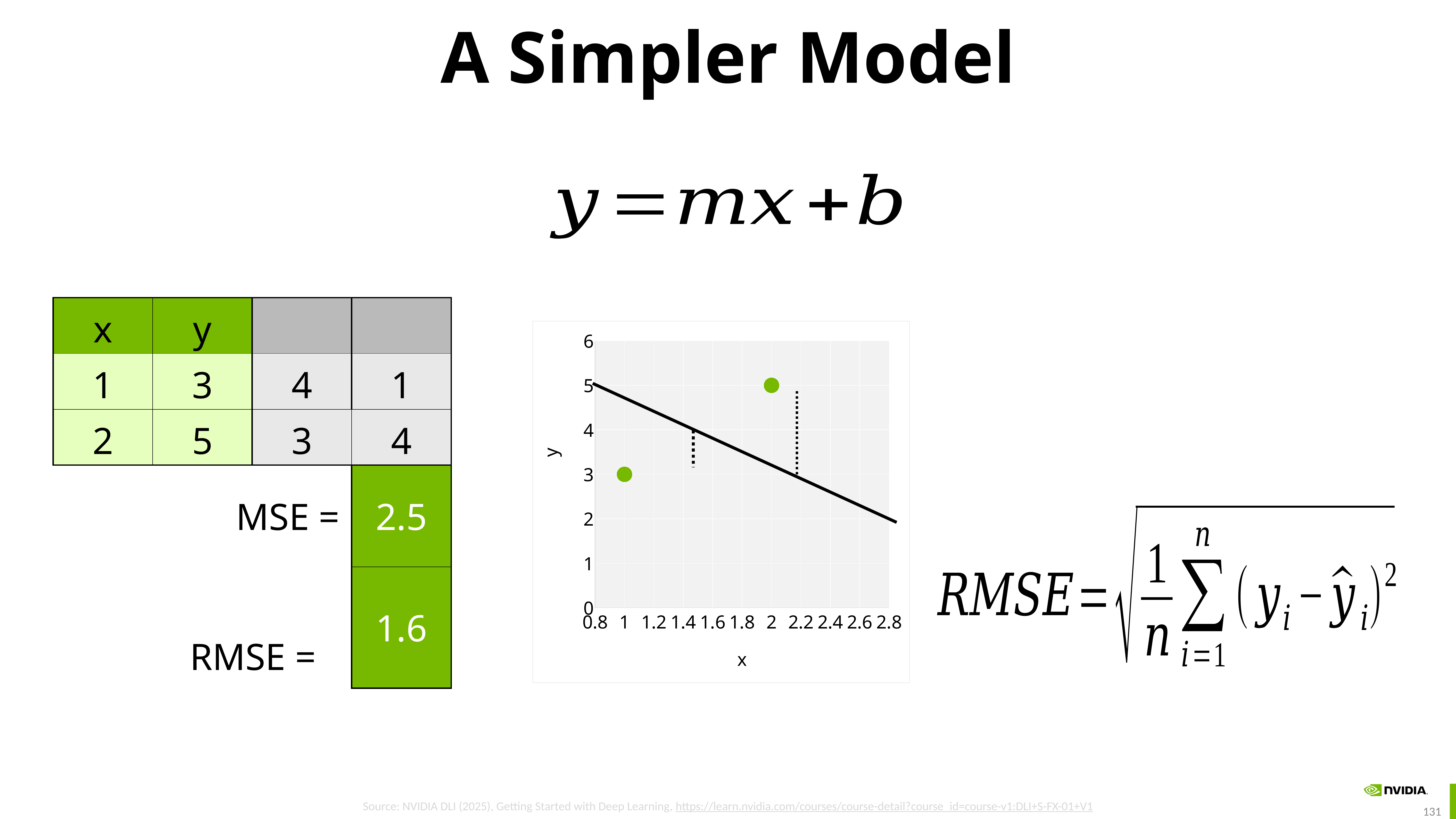
What kind of chart is shown on the slide? scatter chart Does the fitted line rise or fall as x increases? fall Which plotted point has the higher y value, the one at x = 1 or the one at x = 2? x = 2 How many data points are plotted in the chart? 2 Do the plotted points rise or fall as x increases? rise What is the y value of the plotted point at x = 1? 3 What is the label on the horizontal axis of the chart? x What is the highest value shown on the y axis of the chart? 6 What is the y value of the plotted point at x = 2? 5 Is the y value of the fitted line at x = 1 greater or less than 4? greater What is the difference in y between the point at x = 2 and the point at x = 1? 2 Is the y value of the fitted line at x = 2.8 greater or less than 3? less